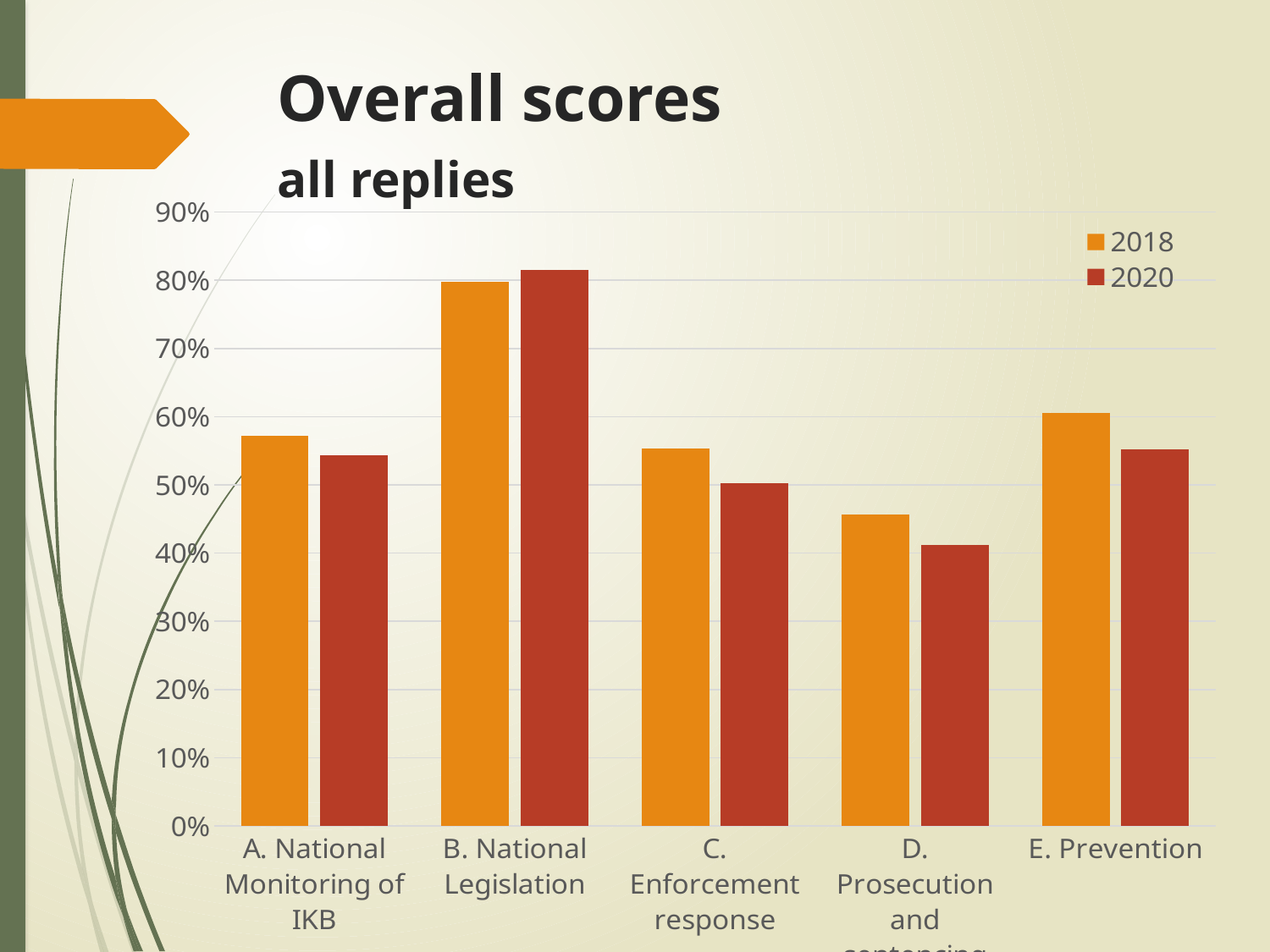
How many series does the legend list? 2 How many categories are shown on the x axis? 5 Is the 2020 value for D. Prosecution greater or less than 50%? less Is the 2018 value for B. National Legislation greater or less than 70%? greater Is the 2018 value for A. National Monitoring of IKB greater or less than 50%? greater For E. Prevention, which series has the larger value, 2018 or 2020? 2018 What are the two entries in the legend? 2018 and 2020 Which category has the highest 2018 score? B. National Legislation Which category has the highest 2020 score? B. National Legislation What kind of chart is shown on the slide? bar chart Which category has the lowest 2018 score? D. Prosecution Which category has the lowest 2020 score? D. Prosecution